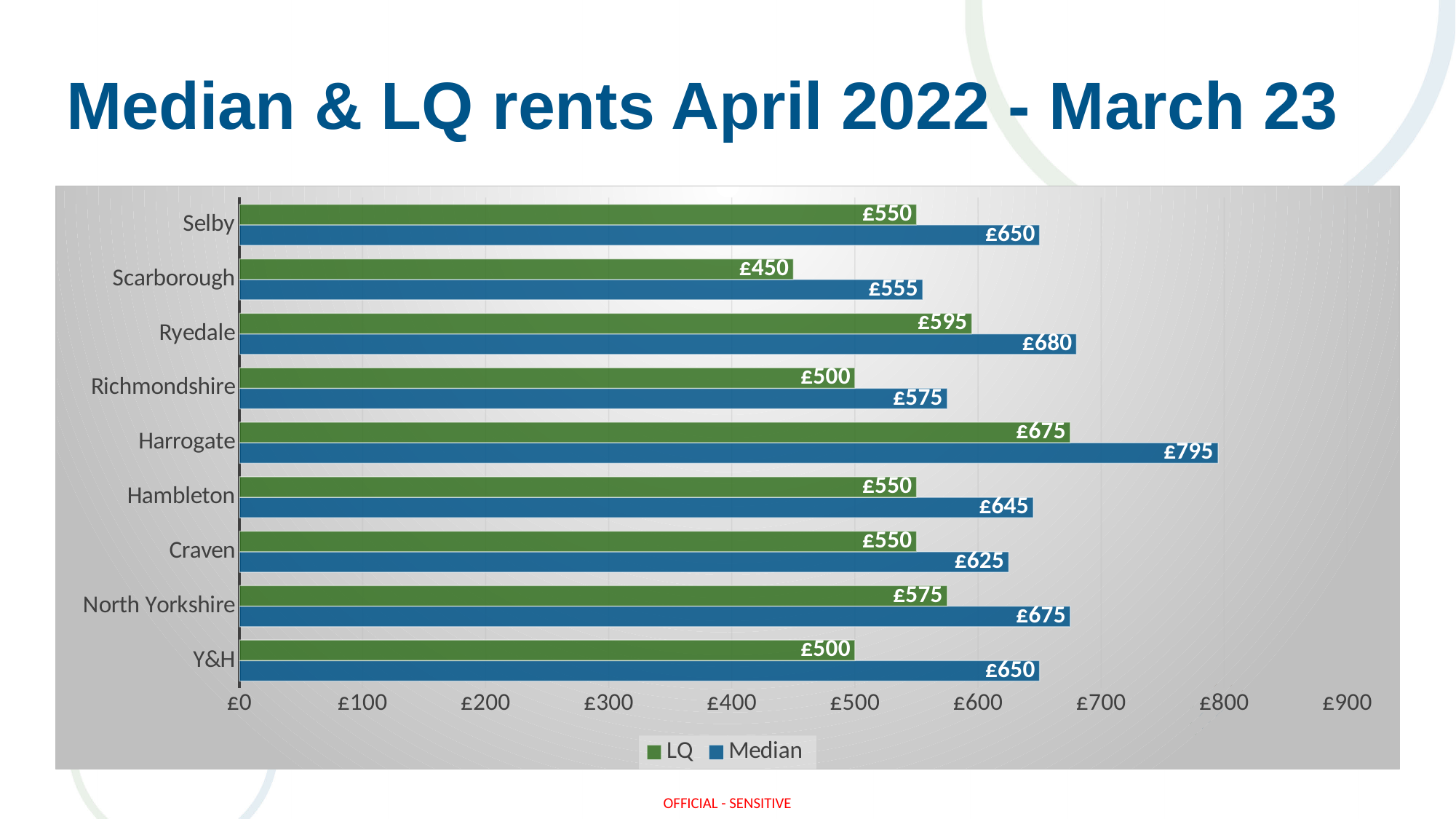
What is the LQ rent for Scarborough? £450 Which colour represents the LQ series in the chart? Green What is the title of the slide? Median & LQ rents April 2022 - March 23 What is the difference between the Median and LQ rents for Ryedale? £85 How many series does the legend list? 2 Which area has the highest Median rent? Harrogate Which area has the lowest LQ rent? Scarborough What kind of chart is shown on the slide? Bar chart Which is larger, the Median rent for Craven or the Median rent for Hambleton? Hambleton How many areas are shown on the chart? 9 What is the Median rent for Y&H? £650 What is the Median rent for Harrogate? £795